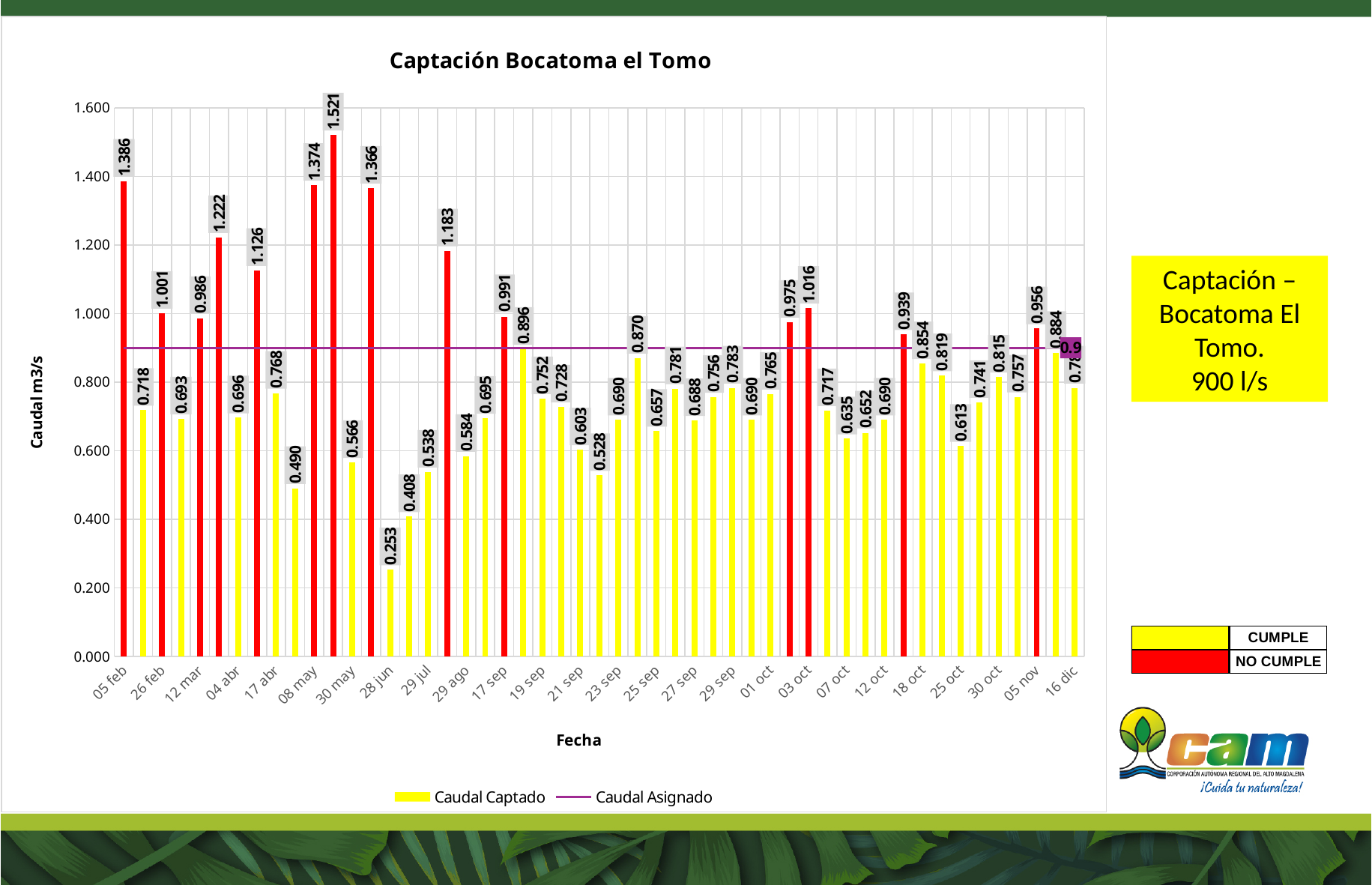
What is the Caudal Captado value for 05 feb? 1.386 What is the Caudal Captado value for 08 may? 1.374 How many series does the legend list? 2 At what value on the y axis is the Caudal Asignado line drawn? 0.9 What is the difference between the highest and lowest Caudal Captado values? 1.268 What type of chart is used to show Caudal Captado? bar chart What is the title of the chart? Captación Bocatoma el Tomo What is the Caudal Captado value for 03 oct? 1.016 What is the lowest Caudal Captado value shown on the chart? 0.253 Which date has the larger Caudal Captado value, 05 feb or 26 feb? 05 feb What is the highest Caudal Captado value shown on the chart? 1.521 What colour are the Caudal Captado bars in the legend? yellow